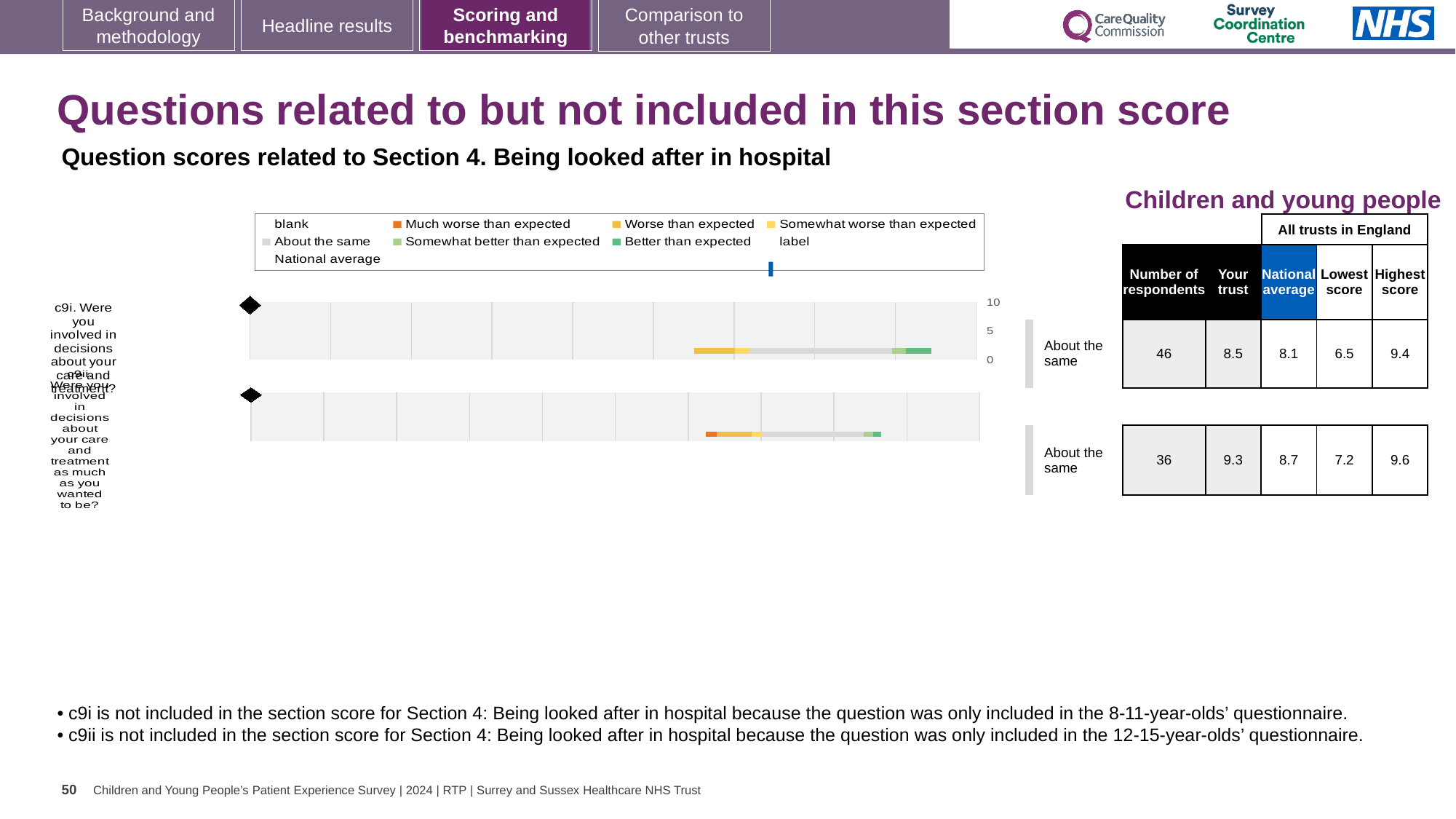
How many respondents answered question c9i? 46 What benchmark category is shown for question c9i? About the same Which question has the higher 'Your trust' score, c9i or c9ii? c9ii How many entries does the chart legend list? 9 What colour does the legend use for 'Better than expected'? green How many questions (bars) are plotted in the chart? 2 What is the national average score for question c9ii? 8.7 What is the title shown above the chart? Question scores related to Section 4. Being looked after in hospital What is the 'Your trust' score for question c9i? 8.5 What is the 'Your trust' score for question c9ii? 9.3 What kind of chart is shown on the slide? bar chart What benchmark category is shown for question c9ii? About the same